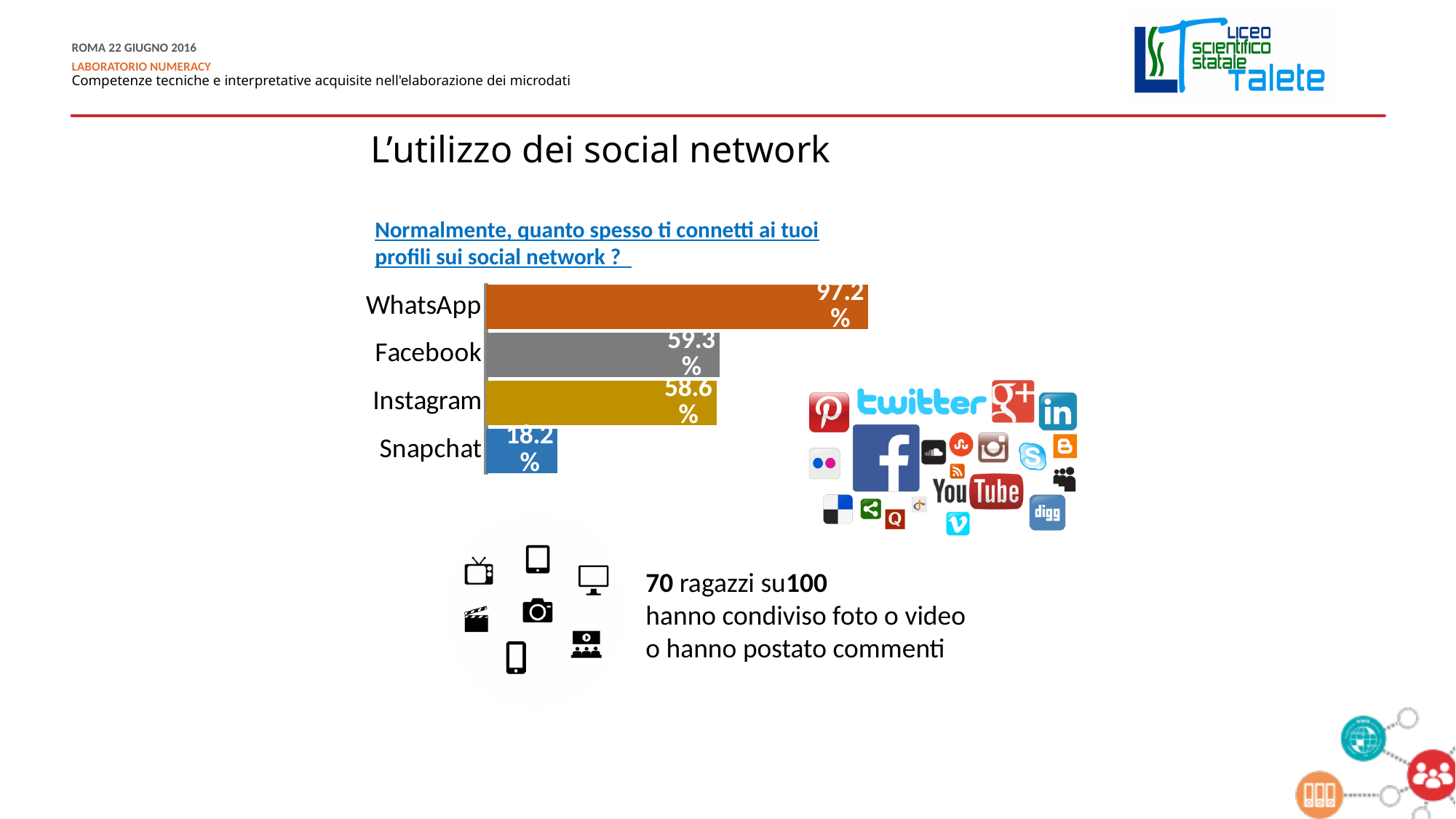
What is the difference between the Facebook and Instagram values in the bar chart? 0.7 percentage points What percentage is shown for WhatsApp in the bar chart? 97.2% What is the difference between the WhatsApp and Snapchat values in the bar chart? 79 percentage points What percentage is shown for Instagram in the bar chart? 58.6% Which has a larger value in the bar chart, Facebook or Snapchat? Facebook How many social networks are shown in the bar chart? 4 What type of chart is used to show the social network data? Bar chart What percentage is shown for Facebook in the bar chart? 59.3% What colour is the WhatsApp bar in the chart? Orange Which social network has the highest value in the bar chart? WhatsApp Which social network has the lowest value in the bar chart? Snapchat What percentage is shown for Snapchat in the bar chart? 18.2%